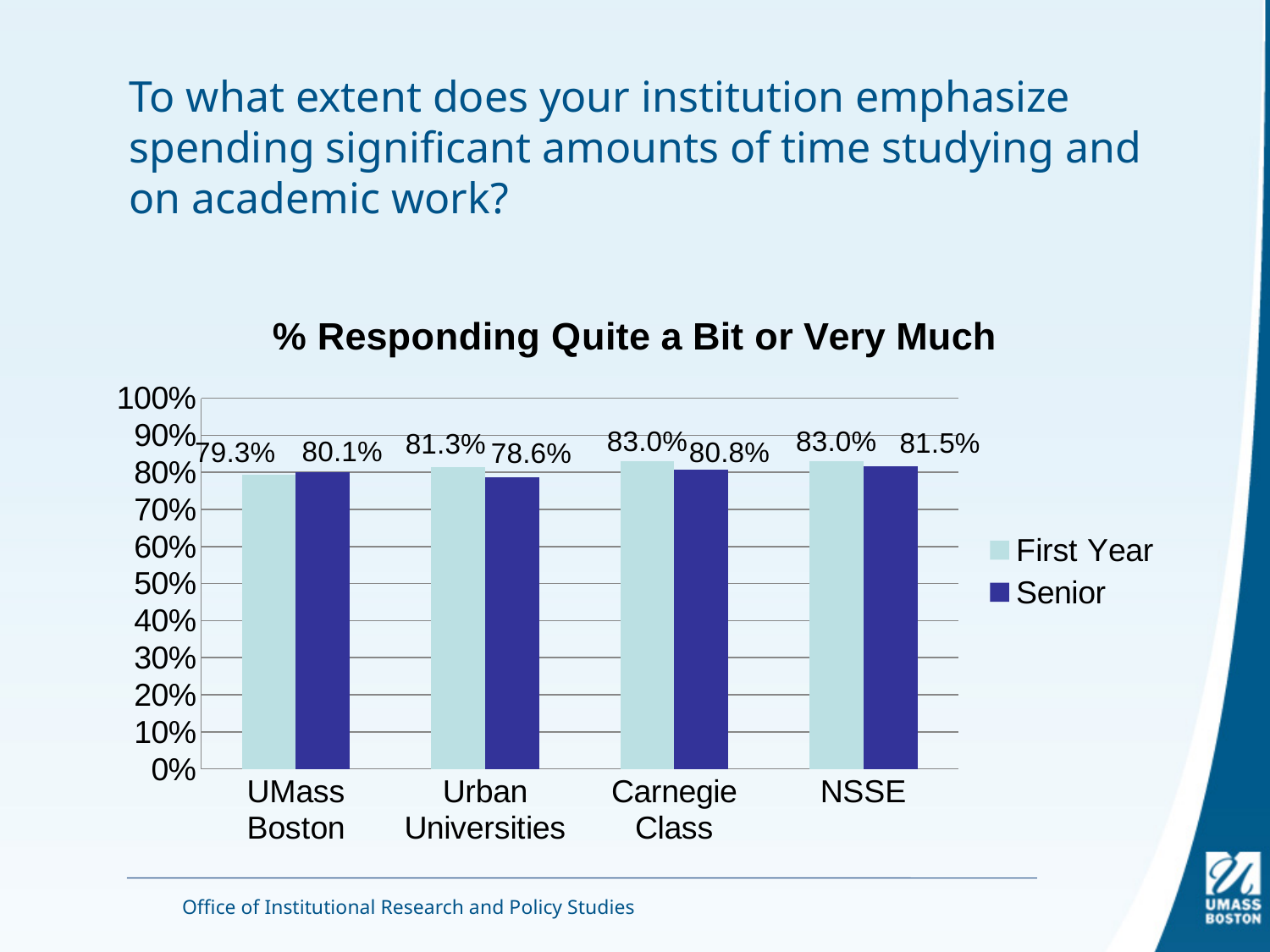
What kind of chart is shown on the slide? Bar chart Which is larger for Carnegie Class, the First Year value or the Senior value? First Year What is the title of the chart? % Responding Quite a Bit or Very Much Which category has the lowest First Year value? UMass Boston What is the difference between the Senior values for NSSE and UMass Boston? 1.4% What is the difference between the First Year and Senior values for Urban Universities? 2.7% How many categories are shown on the x axis? 4 How many series does the legend list? 2 What is the Senior value for Urban Universities? 78.6% What is the Senior value for NSSE? 81.5% Which category has the lowest Senior value? Urban Universities What is the First Year value for UMass Boston? 79.3%